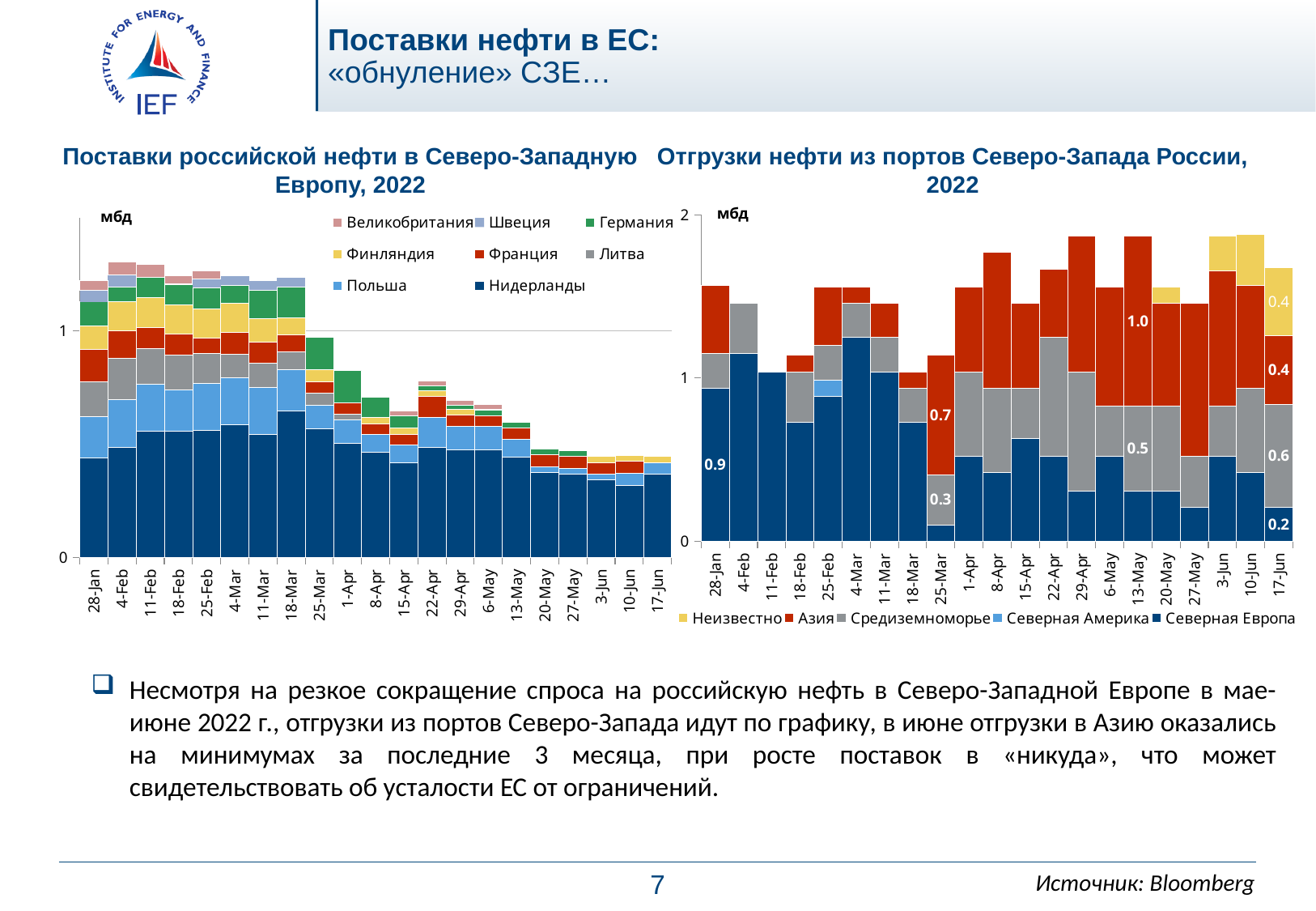
In the right chart ('Отгрузки нефти из портов Северо-Запада России, 2022'), what is the total of the stacked bar for 17-Jun? 1.6 What kind of chart is the left chart, 'Поставки российской нефти в Северо-Западную Европу, 2022'? Stacked bar chart How many dates are shown on the x axis of the right chart ('Отгрузки нефти из портов Северо-Запада России, 2022')? 21 In the right chart ('Отгрузки нефти из портов Северо-Запада России, 2022'), which date has the larger Азия value: 25-Mar or 13-May? 13-May In the right chart ('Отгрузки нефти из портов Северо-Запада России, 2022'), what is the value for Азия on 13-May? 1.0 How many series does the legend of the right chart ('Отгрузки нефти из портов Северо-Запада России, 2022') list? 5 In the left chart ('Поставки российской нефти в Северо-Западную Европу, 2022'), do the total bar heights generally rise or fall from 28-Jan to 17-Jun? fall In the right chart ('Отгрузки нефти из портов Северо-Запада России, 2022'), what is the difference between the Азия value on 13-May and on 17-Jun? 0.6 In the left chart ('Поставки российской нефти в Северо-Западную Европу, 2022'), is the total for 17-Jun greater or less than 1? less How many series does the legend of the left chart ('Поставки российской нефти в Северо-Западную Европу, 2022') list? 8 In the right chart ('Отгрузки нефти из портов Северо-Запада России, 2022'), what is the value for Северная Европа on 28-Jan? 0.9 In the right chart ('Отгрузки нефти из портов Северо-Запада России, 2022'), what is the value for Средиземноморье on 17-Jun? 0.6